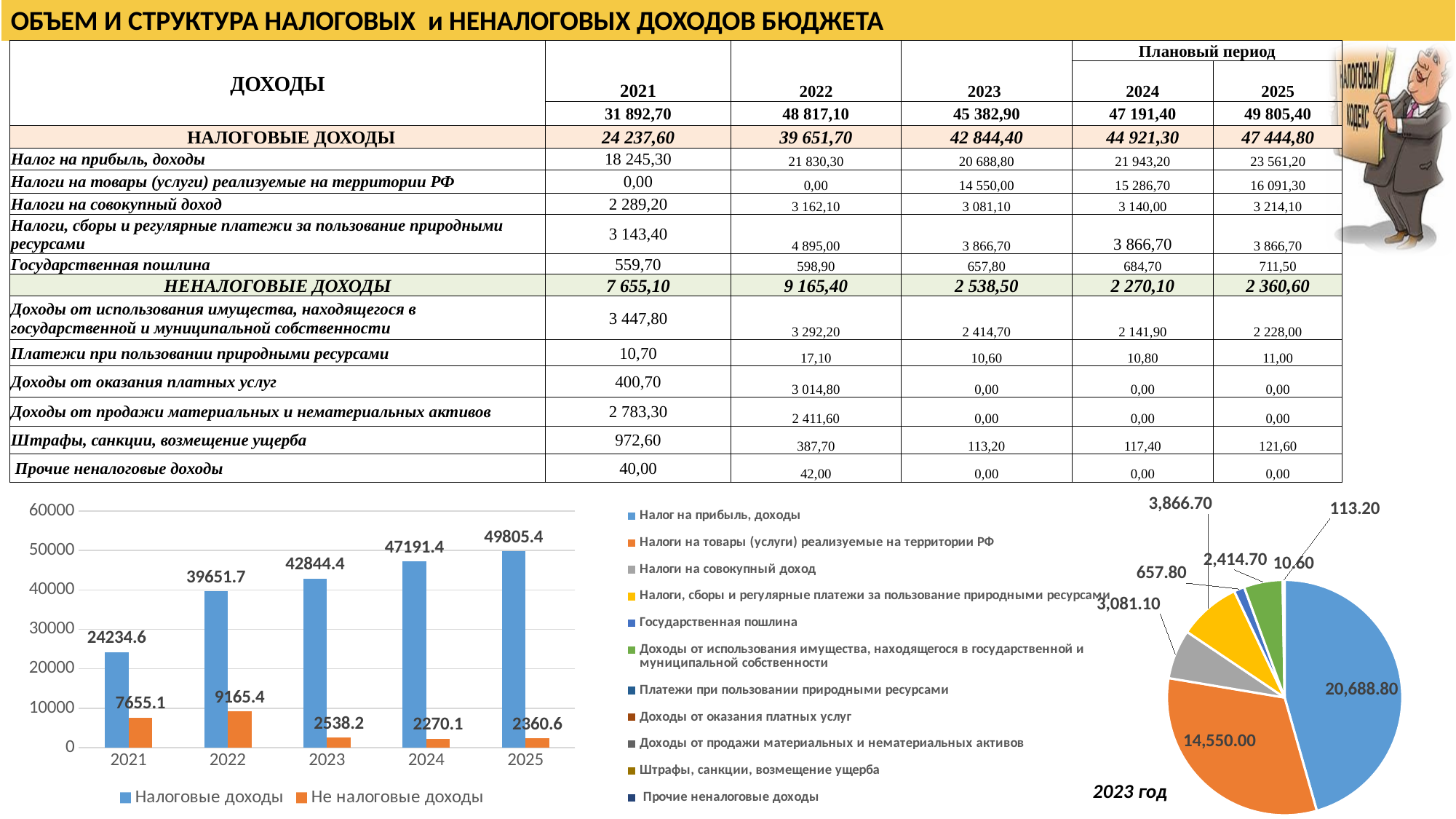
In the bar chart at the bottom left, which is larger: Не налоговые доходы in 2021 or in 2022? 2022 How many series does the legend of the bar chart at the bottom left list? 2 In the bar chart at the bottom left, which year has the highest Налоговые доходы? 2025 In the bar chart at the bottom left, what is the value of Налоговые доходы for 2023? 42844.4 What kind of chart is shown at the bottom left of the slide? bar chart In the pie chart at the bottom right, what is the value of the largest slice? 20,688.80 In the bar chart at the bottom left, is the value of Налоговые доходы for 2024 greater or less than 40000? greater In the bar chart at the bottom left, what is the difference between Налоговые доходы in 2025 and in 2021? 25570.8 In the bar chart at the bottom left, what is the value of Не налоговые доходы for 2022? 9165.4 How many years are shown on the x axis of the bar chart at the bottom left? 5 In the bar chart at the bottom left, which year has the lowest Налоговые доходы? 2021 In the bar chart at the bottom left, do the values of Налоговые доходы rise or fall from 2021 to 2025? rise